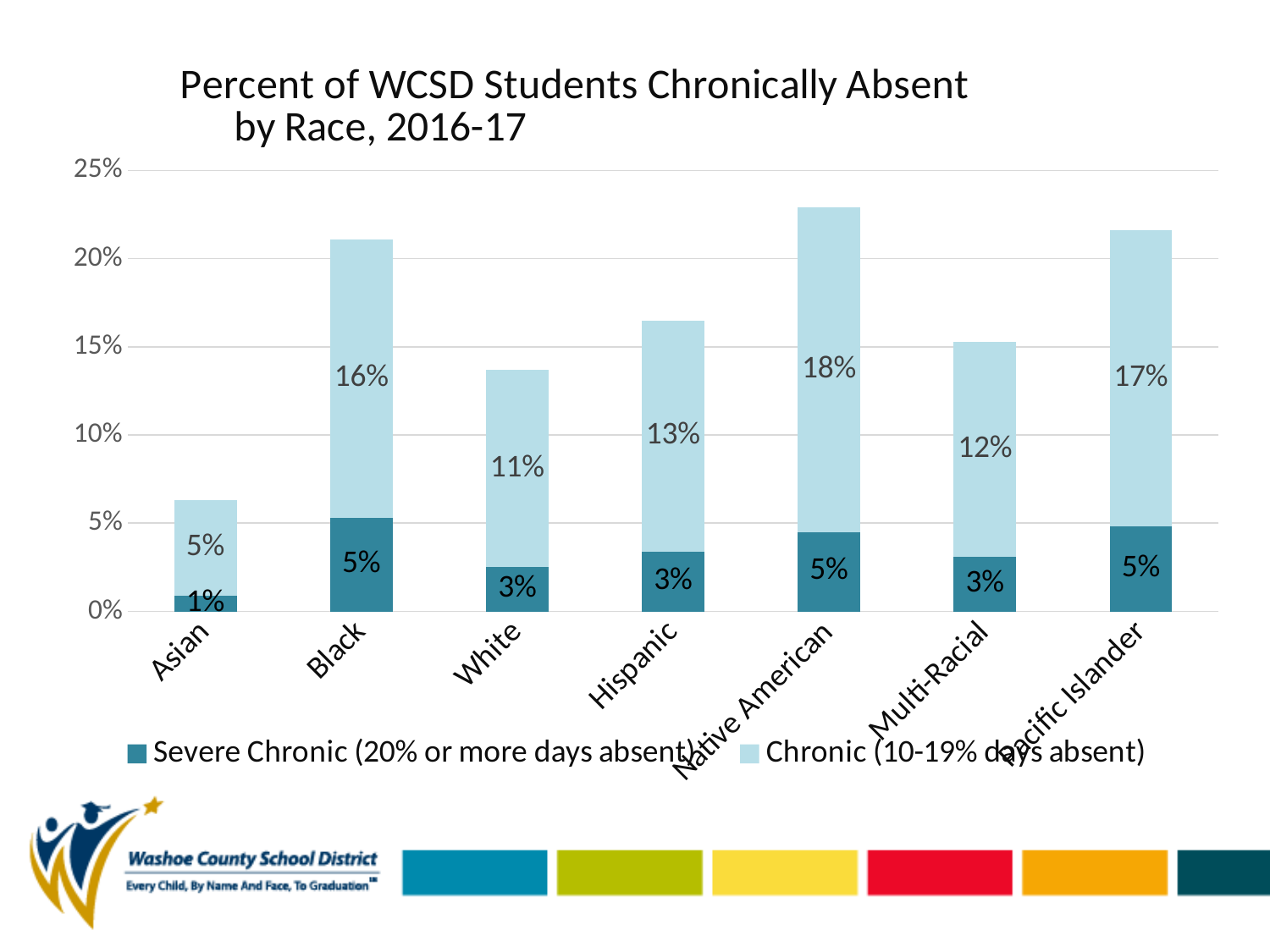
What is the total of the stacked bar for Black students, using the printed labels? 21% What is the Severe Chronic (20% or more days absent) value for Asian students? 1% Is the total stacked bar for Native American students greater or less than 20%? greater Which race has the lowest Severe Chronic (20% or more days absent) value? Asian Which race has the highest Chronic (10-19% days absent) value? Native American How many series does the legend list? 2 What is the Chronic (10-19% days absent) value for Black students? 16% What is the difference between the Chronic (10-19% days absent) values for Black and White students? 5% Which is larger, the Chronic (10-19% days absent) value for Hispanic students or for Multi-Racial students? Hispanic How many race categories are shown on the x axis? 7 What is the Chronic (10-19% days absent) value for Multi-Racial students? 12% What kind of chart is shown on the slide? Stacked bar chart